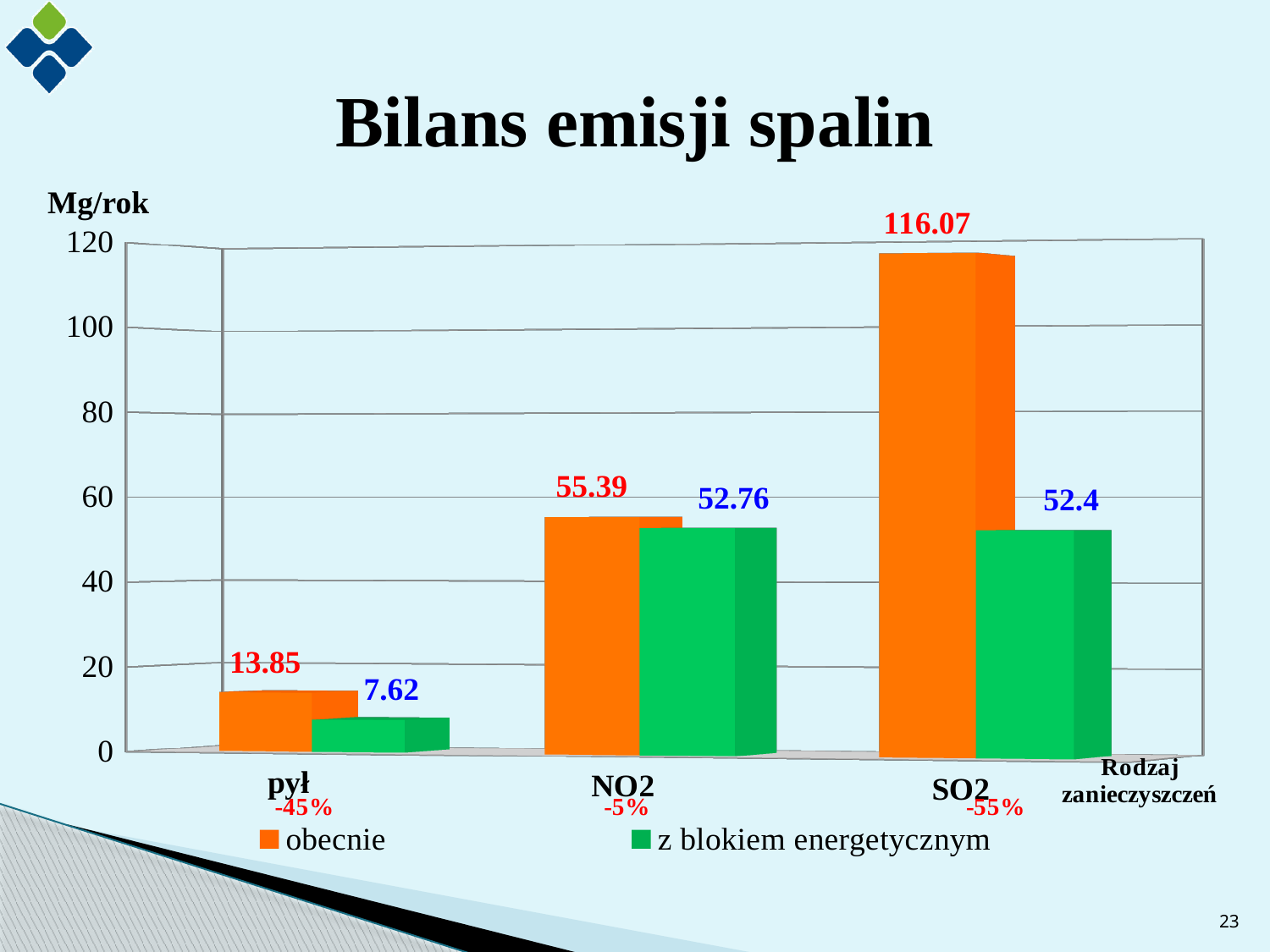
What kind of chart is shown on the slide? bar chart What is the title of the chart? Bilans emisji spalin How many pollutant categories are shown on the x axis? 3 Which category has the highest 'obecnie' value? SO2 How many series does the legend list? 2 Which is larger for pył: the 'obecnie' value or the 'z blokiem energetycznym' value? obecnie What is the value for SO2 in the 'obecnie' series? 116.07 What is the value for NO2 in the 'obecnie' series? 55.39 What is the difference between the 'obecnie' and 'z blokiem energetycznym' values for SO2? 63.67 Which category has the lowest 'z blokiem energetycznym' value? pył Is the 'obecnie' value for SO2 greater or less than 100? greater What is the value for pył in the 'z blokiem energetycznym' series? 7.62